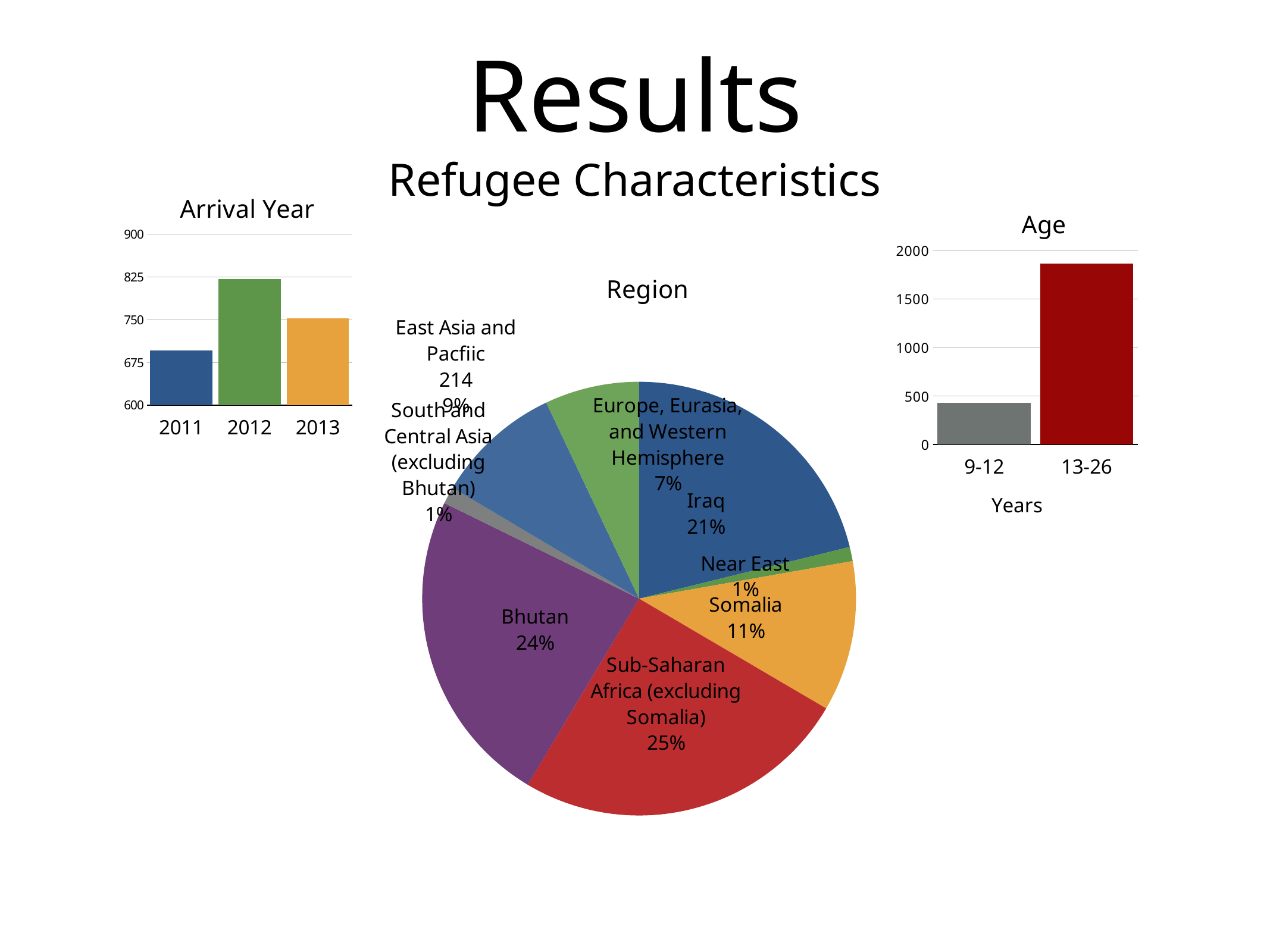
In the Age chart, is the value for 13-26 greater or less than 1500? greater In the Arrival Year chart, is the value for 2011 greater or less than 750? less In the Region pie chart, which region has the largest share? Sub-Saharan Africa (excluding Somalia) In the Region pie chart, what share does Bhutan have? 24% In the Region pie chart, what share does Somalia have? 11% In the Region pie chart, which is larger: the share for Bhutan or the share for Europe, Eurasia, and Western Hemisphere? Bhutan In the Arrival Year chart, which year has the highest bar? 2012 In the Age chart, which age group has the lowest bar? 9-12 In the Region pie chart, how many slices are there? 8 In the Region pie chart, what share does Iraq have? 21% In the Arrival Year chart, what kind of chart is shown? bar chart In the Region pie chart, how much larger is Iraq's share than Somalia's share? 10%